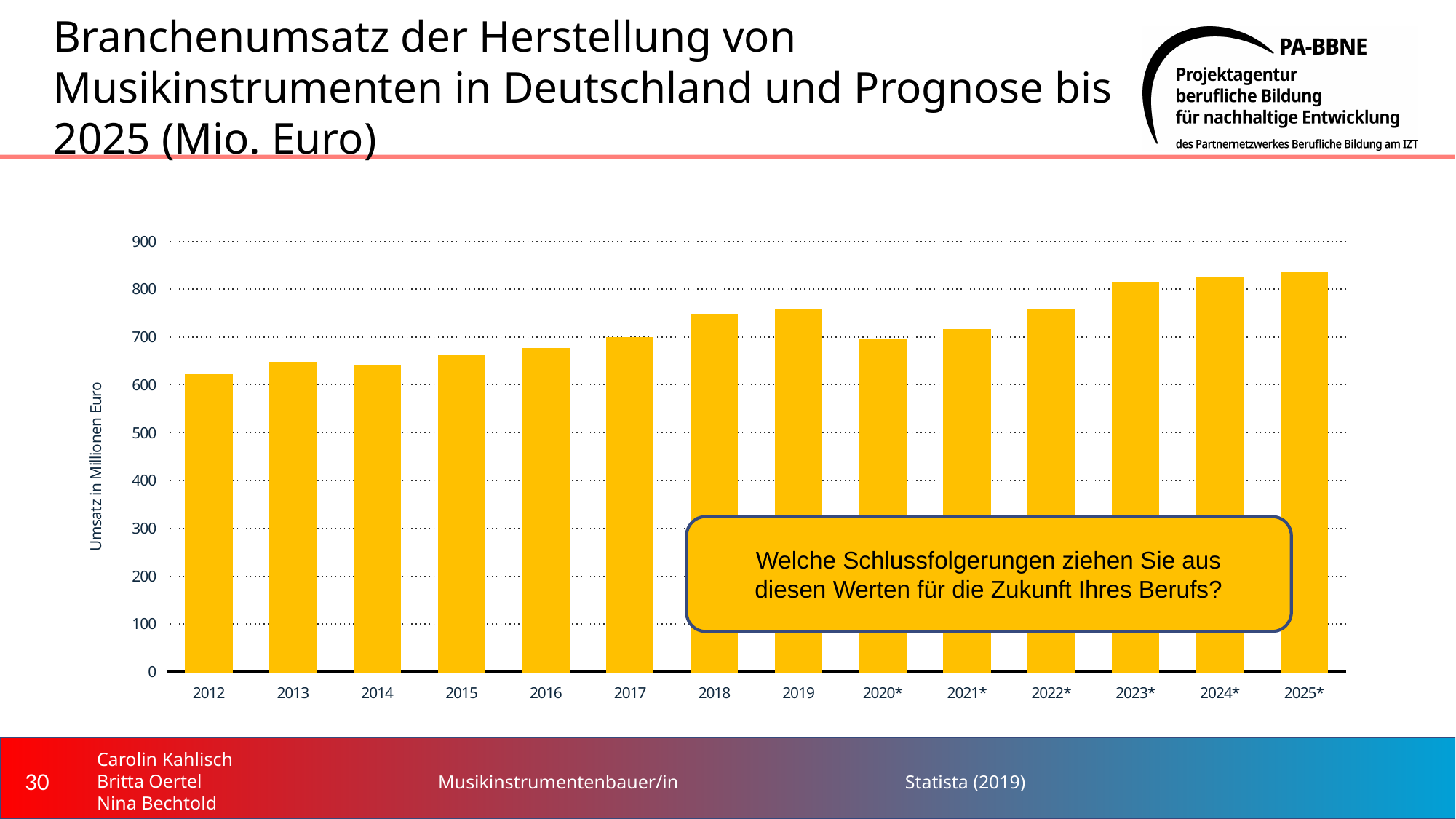
What is the label on the y axis of the chart? Umsatz in Millionen Euro Which is larger, the value for 2012 or the value for 2018? 2018 Which is larger, the value for 2019 or the value for 2020*? 2019 Which year has the lowest bar in the chart? 2012 Is the value for 2012 greater or less than 600? greater Is the value for 2023* greater or less than 800? greater Is the value for 2018 greater or less than 800? less How many years are shown on the x axis of the chart? 14 Do the values generally rise or fall from 2012 to 2025*? rise What kind of chart is shown on the slide? bar chart Which year has the highest bar in the chart? 2025*